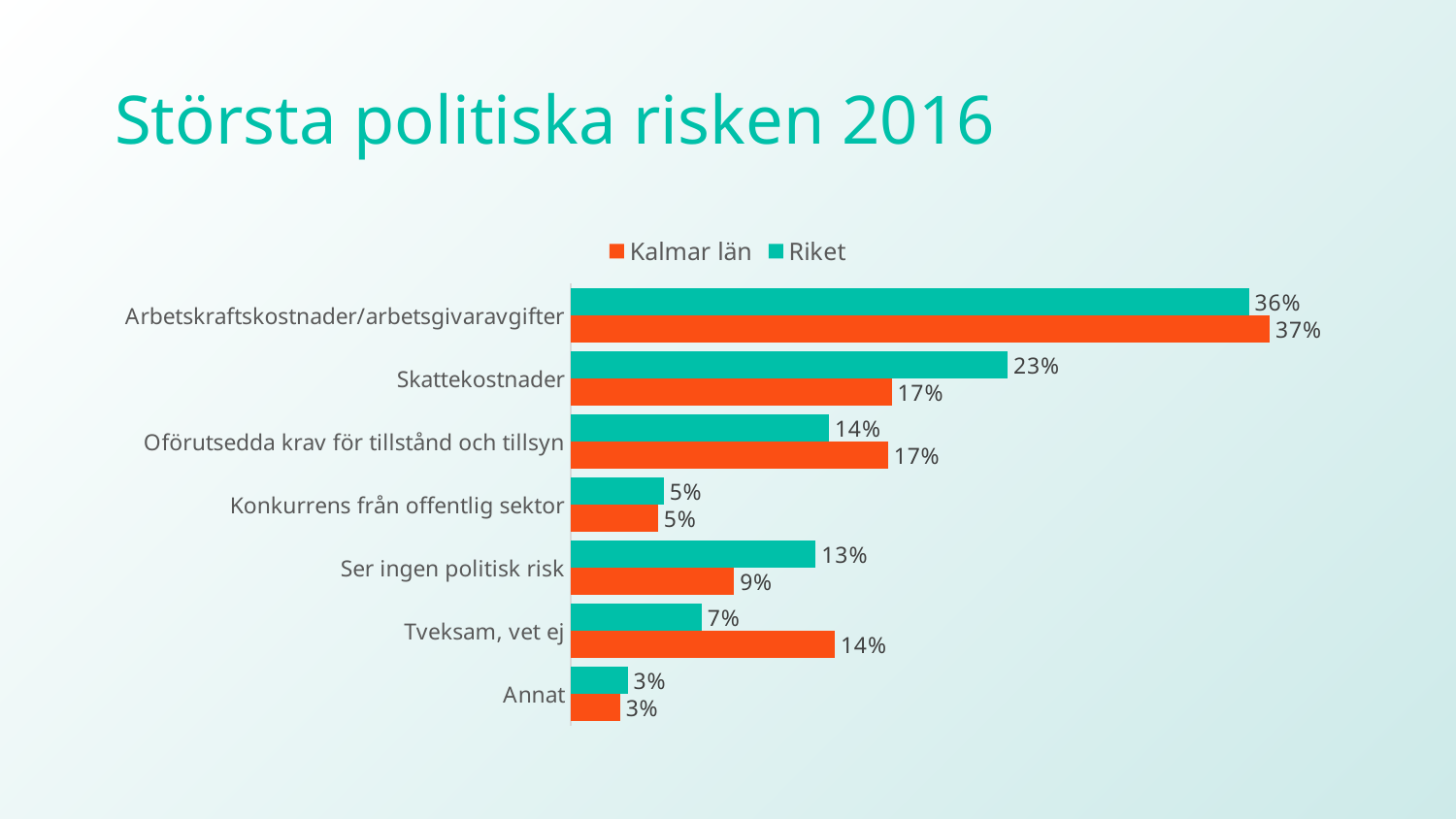
Which category has the highest value for Kalmar län? Arbetskraftskostnader/arbetsgivaravgifter What is the value for Kalmar län for Tveksam, vet ej? 14% What is the value for Kalmar län for Skattekostnader? 17% Which category has the lowest value for Riket? Annat How many series does the legend list? 2 For Oförutsedda krav för tillstånd och tillsyn, which series has the larger value, Kalmar län or Riket? Kalmar län What is the value for Riket for Ser ingen politisk risk? 13% What kind of chart is shown on the slide? Bar chart What is the title of the slide? Största politiska risken 2016 How many categories are shown on the chart? 7 What is the difference between the Kalmar län and Riket values for Tveksam, vet ej? 7% What is the difference between the Riket and Kalmar län values for Skattekostnader? 6%